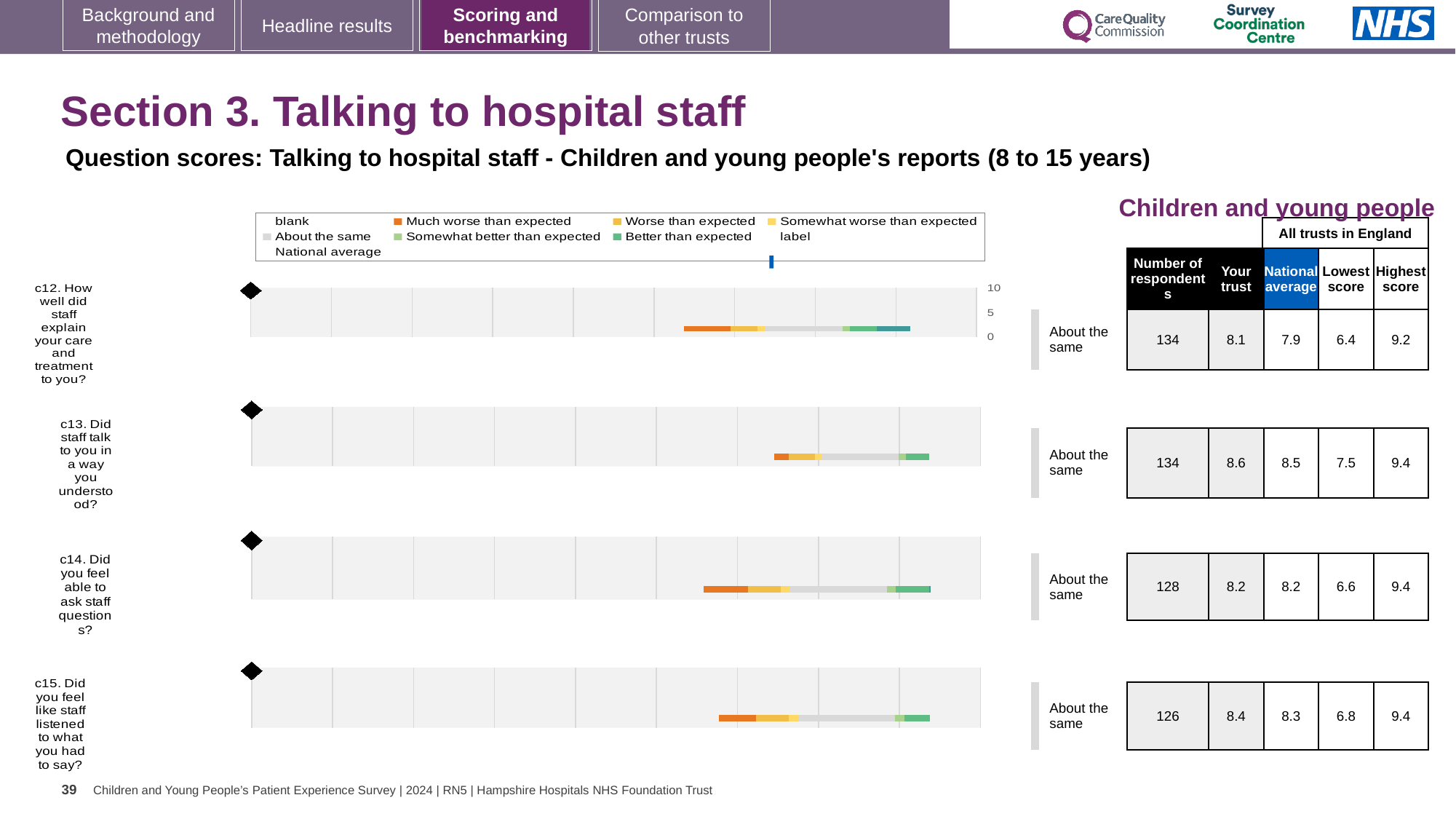
What is the highest score among all trusts in England for c12? 9.2 How many survey questions (categories) are plotted on the chart? 4 Which question has the lowest 'Your trust' score? c12. How well did staff explain your care and treatment to you? For c15, is the 'Your trust' score higher or lower than the national average? higher What is the 'Your trust' score for c13 (Did staff talk to you in a way you understood?)? 8.6 Which question has the highest 'Your trust' score? c13. Did staff talk to you in a way you understood? What is the national average score for c12 (How well did staff explain your care and treatment to you?)? 7.9 What kind of chart is used to show the question scores? bar chart What benchmark category is shown for c14 (Did you feel able to ask staff questions?)? About the same How many respondents answered c15 (Did you feel like staff listened to what you had to say?)? 126 What is the lowest score among all trusts in England for c13? 7.5 What is the difference between the 'Your trust' score and the national average for c12? 0.2